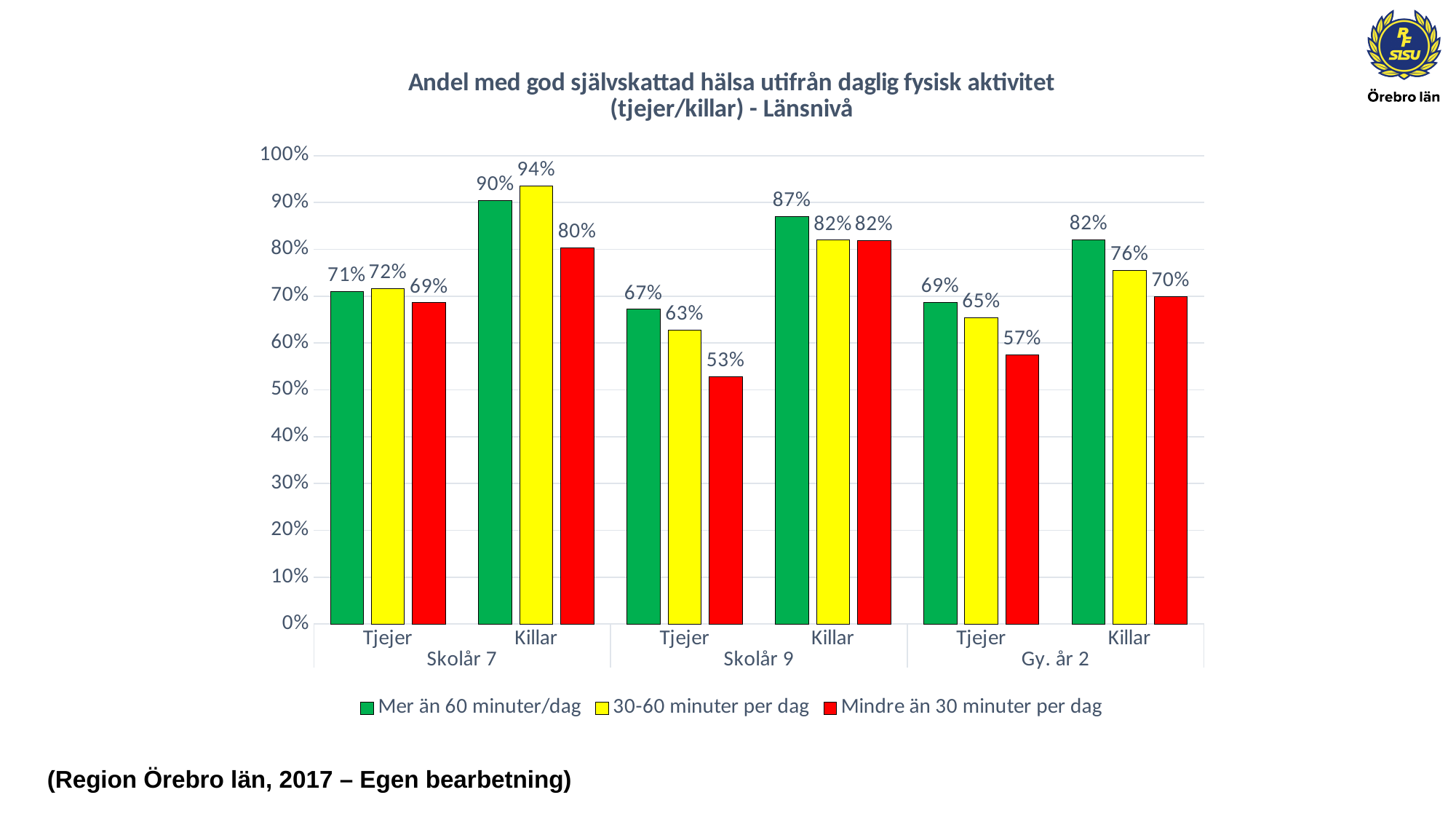
Is the value for Killar in Skolår 7 for 'Mindre än 30 minuter per dag' greater or less than 70%? greater What kind of chart is shown on the slide? Bar chart What colour represents the series 'Mindre än 30 minuter per dag'? Red Which group and series has the lowest value in the chart? Tjejer, Skolår 9, Mindre än 30 minuter per dag (53%) What is the value for Killar in Skolår 7 for the series 'Mer än 60 minuter/dag'? 90% Which is larger for Tjejer in Gy. år 2: 'Mer än 60 minuter/dag' or 'Mindre än 30 minuter per dag'? Mer än 60 minuter/dag What is the difference between the 'Mer än 60 minuter/dag' value for Killar and for Tjejer in Skolår 9? 20 percentage points What is the value for Tjejer in Skolår 9 for the series 'Mindre än 30 minuter per dag'? 53% What is the value for Killar in Gy. år 2 for the series '30-60 minuter per dag'? 76% Which group and series has the highest value in the chart? Killar, Skolår 7, 30-60 minuter per dag (94%) How many series does the legend list? 3 How many groups of bars (Tjejer/Killar categories) are shown on the x axis? 6